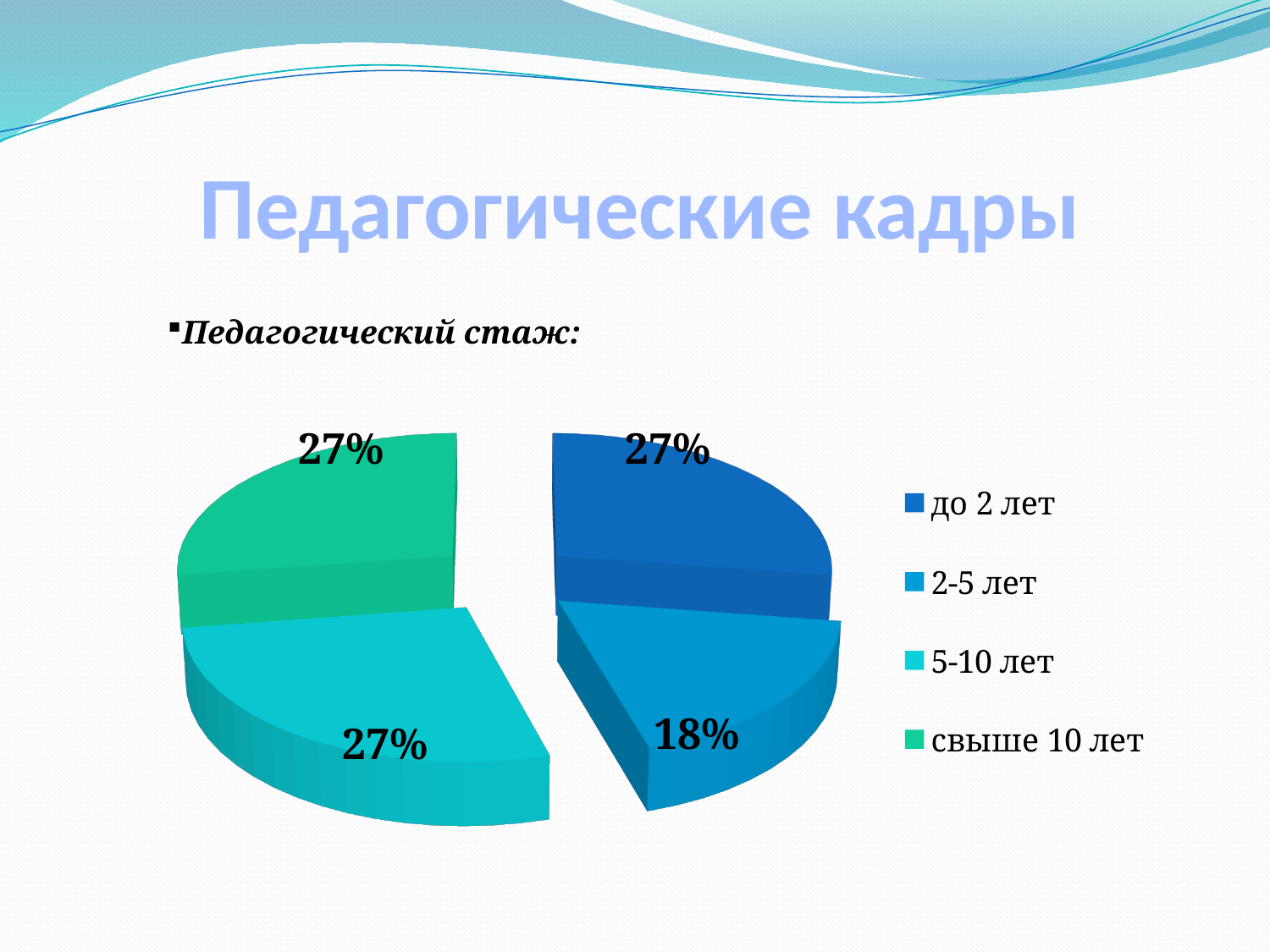
What share of the pie does the "2-5 лет" category represent? 18% By how many percentage points does the "5-10 лет" slice exceed the "2-5 лет" slice? 9 percentage points What percentage is shown for the "5-10 лет" slice? 27% How many slices does the pie chart have? 4 What percentage is shown for the "свыше 10 лет" slice? 27% What percentage is shown for the "до 2 лет" slice? 27% What percentage is shown for the "2-5 лет" slice? 18% Which is larger: the slice for "до 2 лет" or the slice for "2-5 лет"? до 2 лет What kind of chart is shown on the slide? Pie chart Which category has the smallest slice of the pie? 2-5 лет How many entries does the legend list? 4 What is the title of the slide containing the pie chart? Педагогические кадры